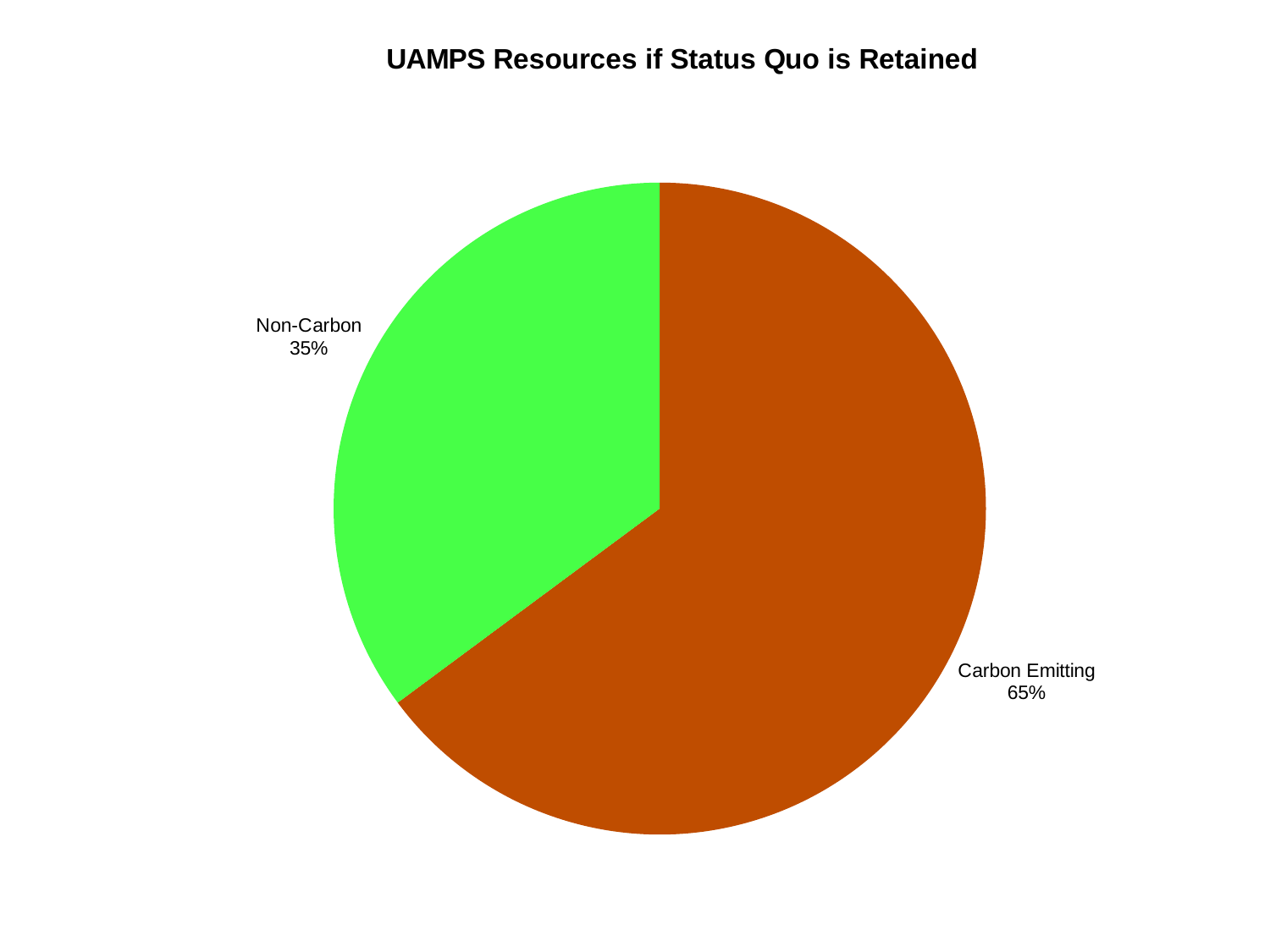
Which slice is the smallest? Non-Carbon What share of the pie is Carbon Emitting? 65% Which slice is the largest? Carbon Emitting What is the difference in percentage points between Carbon Emitting and Non-Carbon? 30 How many slices does the pie chart have? 2 What colour is the Non-Carbon slice? green Which is larger, Non-Carbon or Carbon Emitting? Carbon Emitting What share of the pie is Non-Carbon? 35% What kind of chart is shown on the slide? pie chart What is the title of the chart? UAMPS Resources if Status Quo is Retained Is the share for Carbon Emitting greater or less than 50%? greater